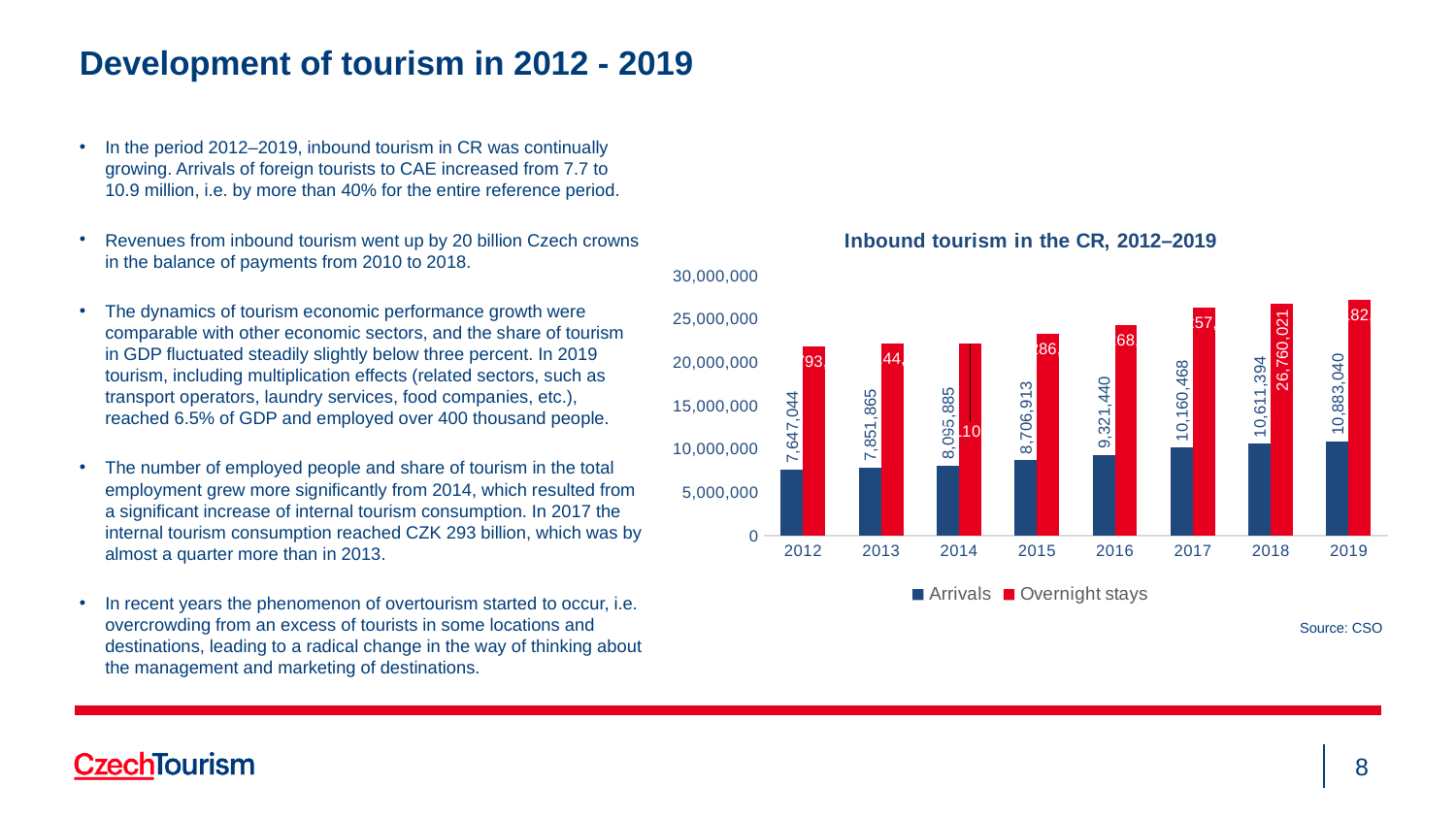
Do Arrivals rise or fall from 2012 to 2019? Rise What is the value of Arrivals for 2016? 9,321,440 Is the value of Overnight stays for 2012 greater or less than 25,000,000? less Which year has the lowest number of Arrivals? 2012 How many series does the legend list? 2 Which year has the highest number of Arrivals? 2019 What is the value of Overnight stays for 2018? 26,760,021 Which is larger, Arrivals in 2017 or Arrivals in 2018? 2018 What is the value of Arrivals for 2012 in the Inbound tourism in the CR chart? 7,647,044 What kind of chart is shown on the slide? Bar chart What is the difference in Arrivals between 2019 and 2012? 3,235,996 How many years are shown on the x axis of the chart? 8